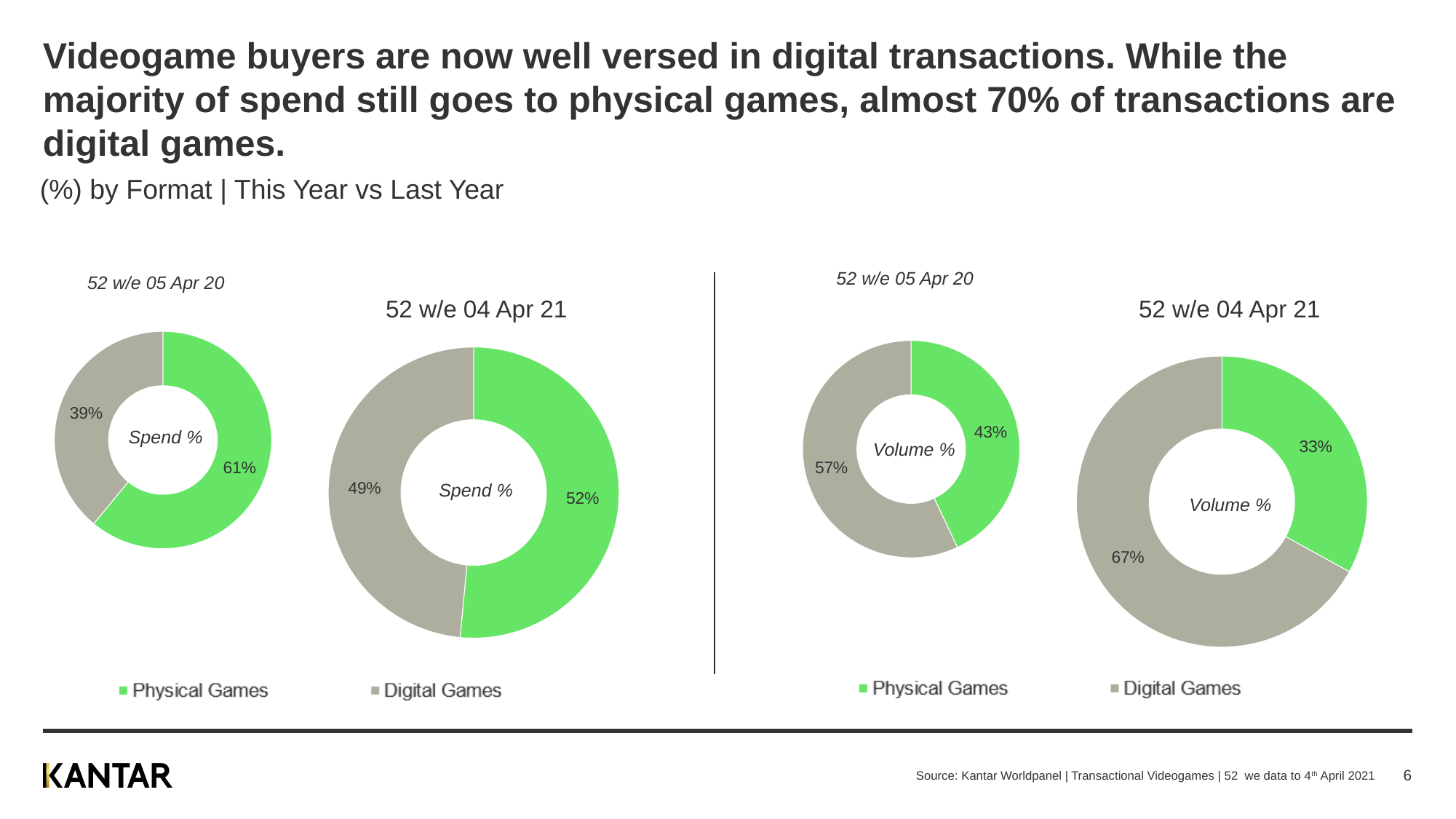
In the Volume % donut chart for 52 w/e 04 Apr 21, what share is Digital Games? 67% How many series does the legend under the Spend % charts list? 2 In the Volume % donut chart for 52 w/e 05 Apr 20, what is the difference between the Digital Games share and the Physical Games share? 14 percentage points In the Spend % donut chart for 52 w/e 04 Apr 21, what share is Physical Games? 52% In the Spend % donut chart for 52 w/e 05 Apr 20, what share is Digital Games? 39% In the Spend % donut chart for 52 w/e 05 Apr 20, which format has the smaller share? Digital Games In the Volume % donut chart for 52 w/e 05 Apr 20, what share is Physical Games? 43% In the Spend % donut chart for 52 w/e 05 Apr 20, what share is Physical Games? 61% What type of chart is used to show the Spend % and Volume % splits on this slide? Donut (pie) chart In the Volume % donut chart for 52 w/e 04 Apr 21, which format has the larger share? Digital Games In the Spend % donut chart for 52 w/e 04 Apr 21, what share is Digital Games? 49% Comparing the Volume % charts, is the Physical Games share larger in 52 w/e 05 Apr 20 or in 52 w/e 04 Apr 21? 52 w/e 05 Apr 20